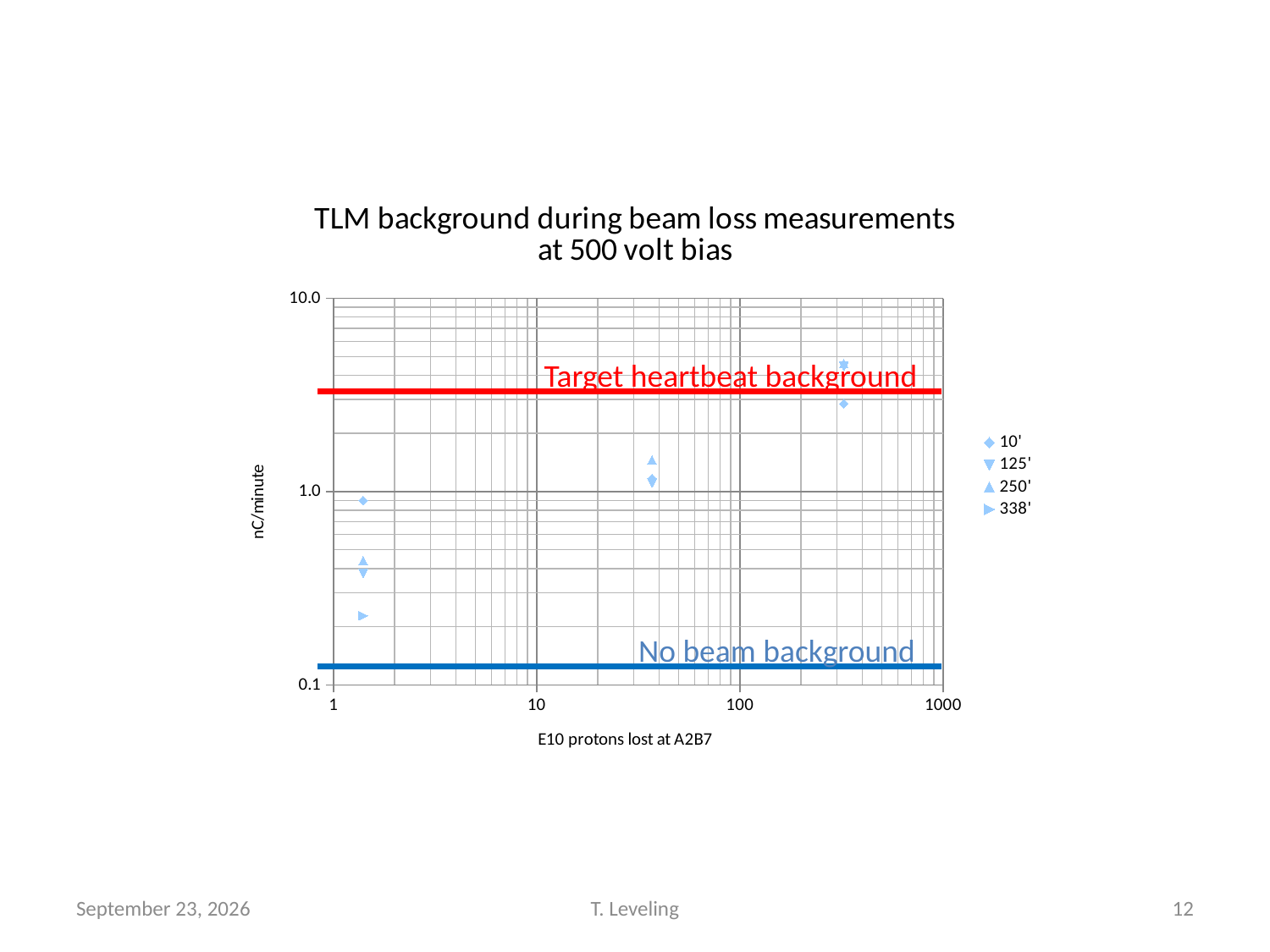
Do the values for the 10' series rise or fall as the number of protons lost increases? rise Is the value for the 125' series at the lowest proton-loss point greater or less than 1.0 nC/minute? less At the lowest proton-loss point, which series has the larger value: 10' or 338'? 10' Is the value for the 250' series near 40 E10 protons lost greater or less than 1.0 nC/minute? greater Which series has the highest plotted value on the chart? 250' What kind of chart is shown on the slide? scatter chart Is the value for the 338' series at the lowest proton-loss point greater or less than 1.0 nC/minute? less What is the title of the chart? TLM background during beam loss measurements at 500 volt bias At the lowest proton-loss point, which series has the lowest value? 338' What label is on the vertical axis of the chart? nC/minute How many series does the legend list? 4